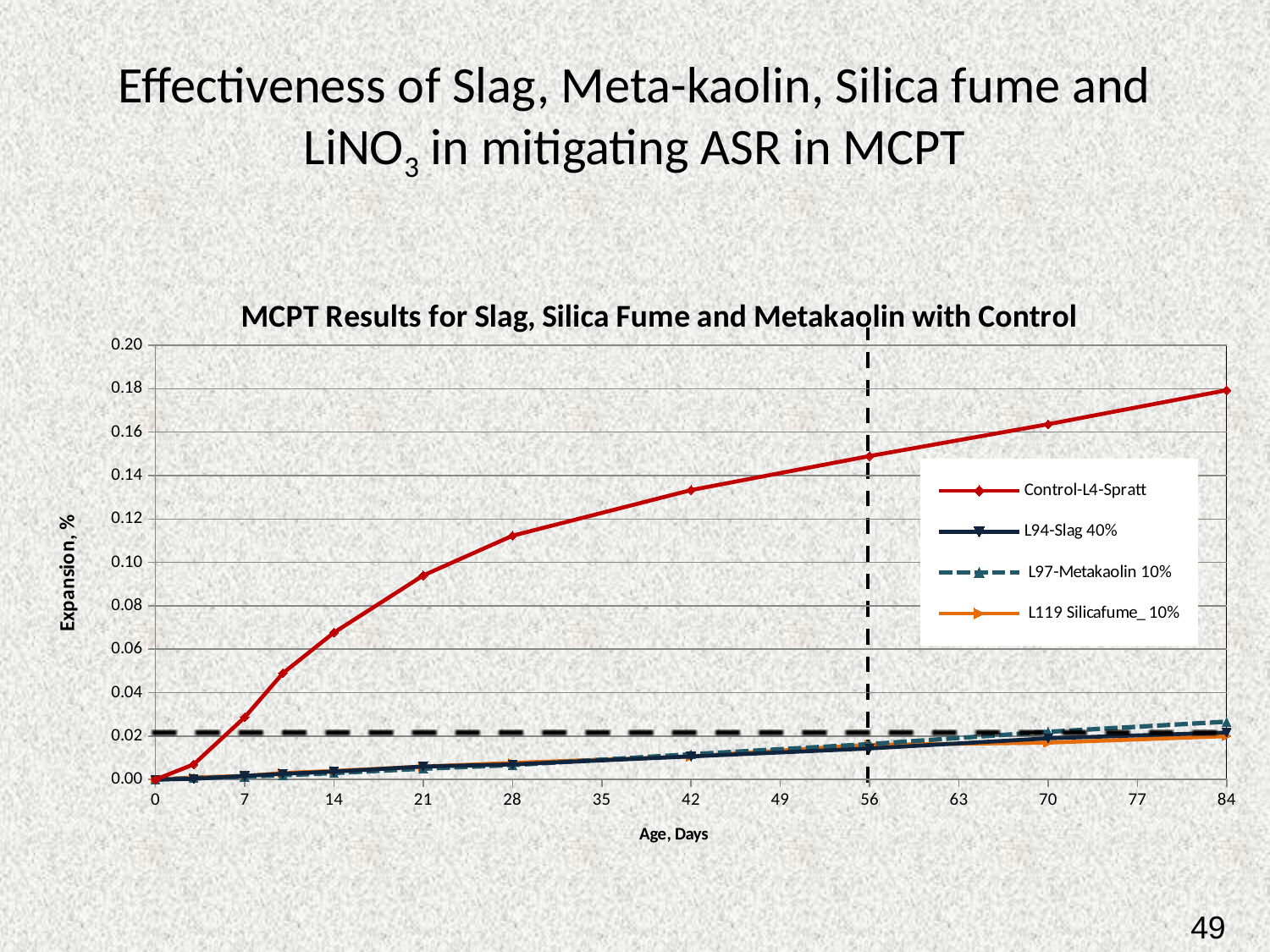
Does the expansion for Control-L4-Spratt rise or fall as age in days increases? rise What is the label of the y axis of the chart? Expansion, % Is the expansion for L94-Slag 40% at 84 days greater or less than 0.04? less Is the expansion for Control-L4-Spratt at 28 days greater or less than 0.10? greater Is the expansion for Control-L4-Spratt at 14 days greater or less than 0.06? greater How many series does the chart legend list? 4 Which series has the highest expansion at 84 days? Control-L4-Spratt What is the title of the chart? MCPT Results for Slag, Silica Fume and Metakaolin with Control Which is larger at 84 days, the expansion for Control-L4-Spratt or for L94-Slag 40%? Control-L4-Spratt What kind of chart is shown on the slide? line chart